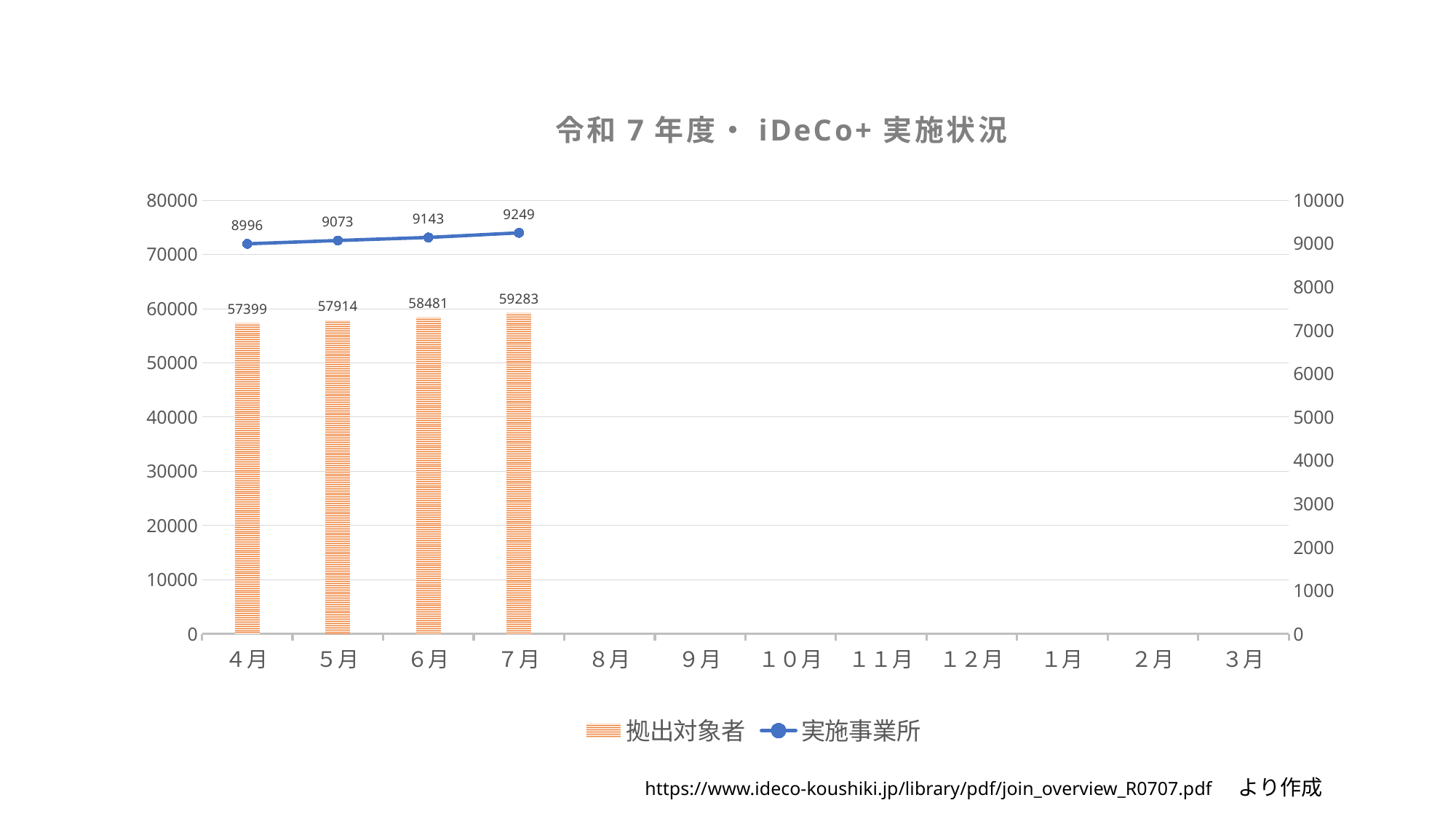
Which month has the lowest 実施事業所 value among the plotted months? 4月 Do the 実施事業所 values rise or fall from 4月 to 7月? rise What is the value of 実施事業所 for 7月? 9249 What is the value of 拠出対象者 for 4月? 57399 How many months have plotted data in the chart? 4 What is the value of 実施事業所 for 5月? 9073 What is the difference between the 拠出対象者 values for 7月 and 4月? 1884 What is the difference between the 実施事業所 values for 6月 and 5月? 70 Which month has the highest 拠出対象者 value among the plotted months? 7月 Which is larger, the 拠出対象者 value for 5月 or for 6月? 6月 What is the value of 拠出対象者 for 6月? 58481 How many series does the legend list? 2